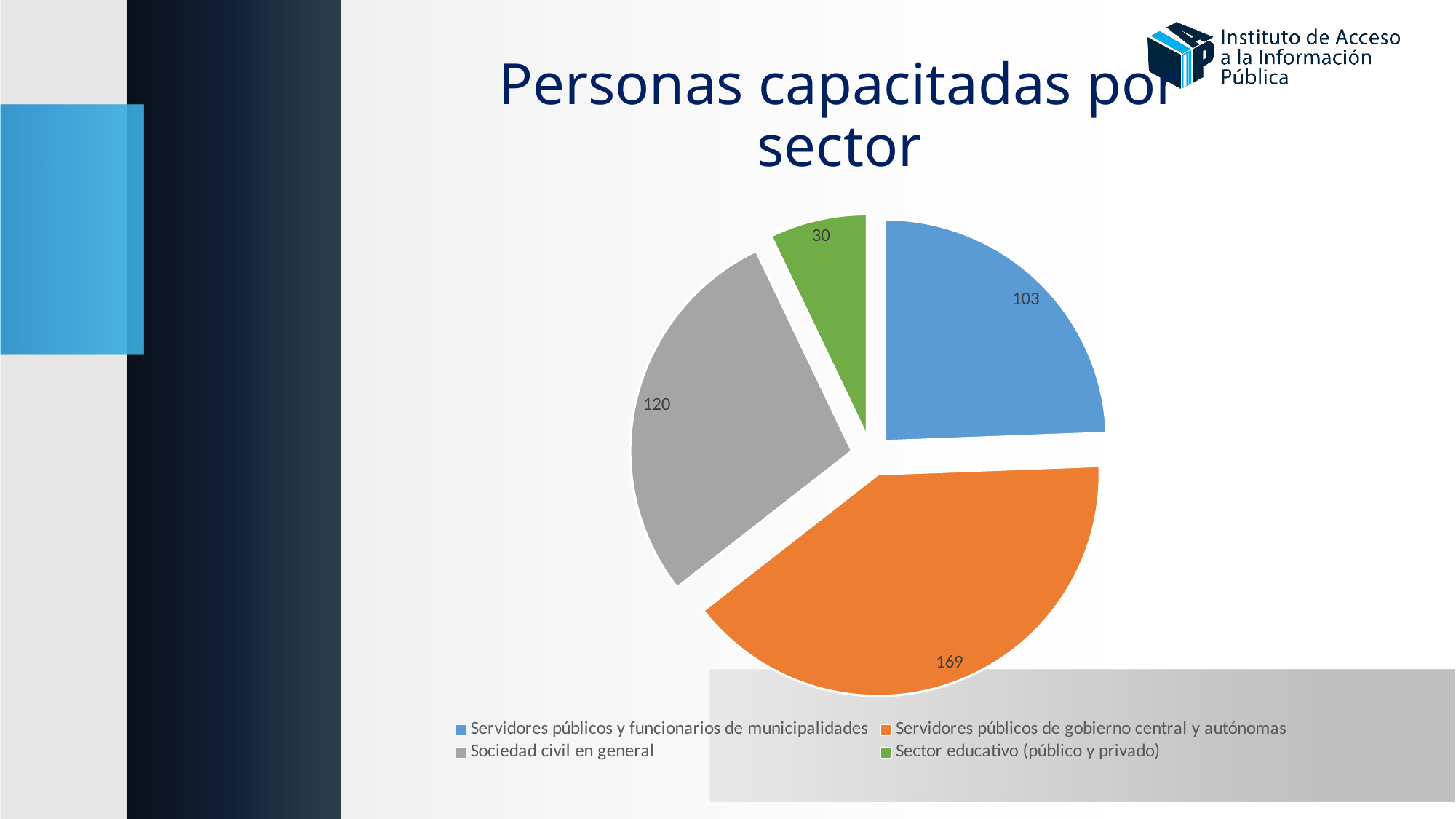
Which is larger: the value for Sociedad civil en general or the value for Servidores públicos y funcionarios de municipalidades? Sociedad civil en general What is the difference between the values for Servidores públicos de gobierno central y autónomas and Sociedad civil en general? 49 What colour is the slice for Sociedad civil en general? Gray Which sector has the largest slice? Servidores públicos de gobierno central y autónomas How many slices does the pie chart have? 4 Which sector has the smallest slice? Sector educativo (público y privado) What is the value for Sociedad civil en general? 120 What is the value for Servidores públicos de gobierno central y autónomas? 169 What is the title of the chart? Personas capacitadas por sector What is the value for Sector educativo (público y privado)? 30 What is the value for Servidores públicos y funcionarios de municipalidades? 103 What type of chart is shown on the slide? Pie chart